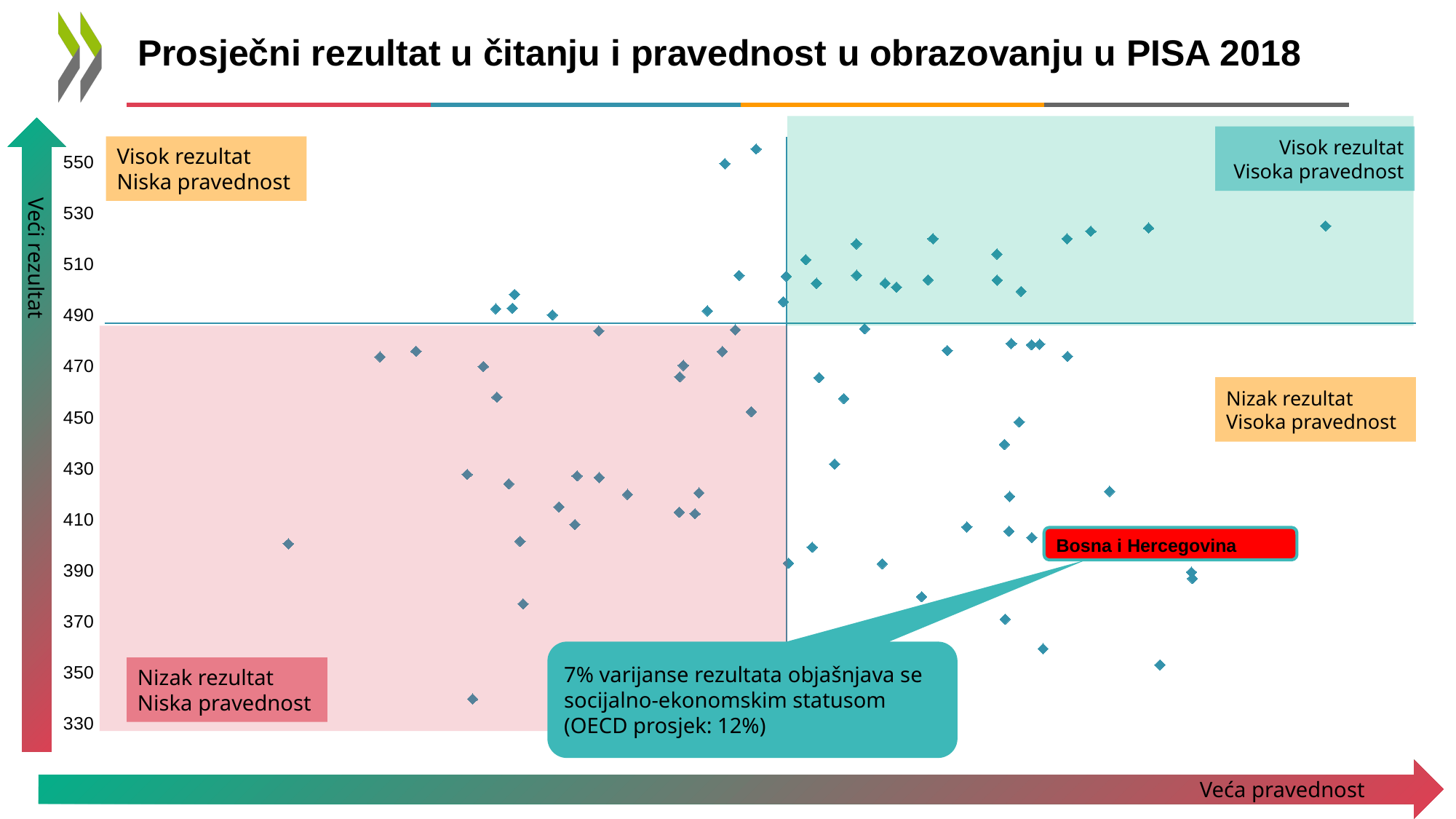
What is the highest value shown on the vertical axis? 550 What is the lowest value shown on the vertical axis? 330 Is the reading score for Bosna i Hercegovina greater or less than 370? greater Is the reading score for Bosna i Hercegovina greater or less than 450? less Is the reading score for Bosna i Hercegovina greater or less than 490? less What kind of chart is shown on the slide? scatter plot What is the title of the chart? Prosječni rezultat u čitanju i pravednost u obrazovanju u PISA 2018 Which country is labelled with a callout on the chart? Bosna i Hercegovina